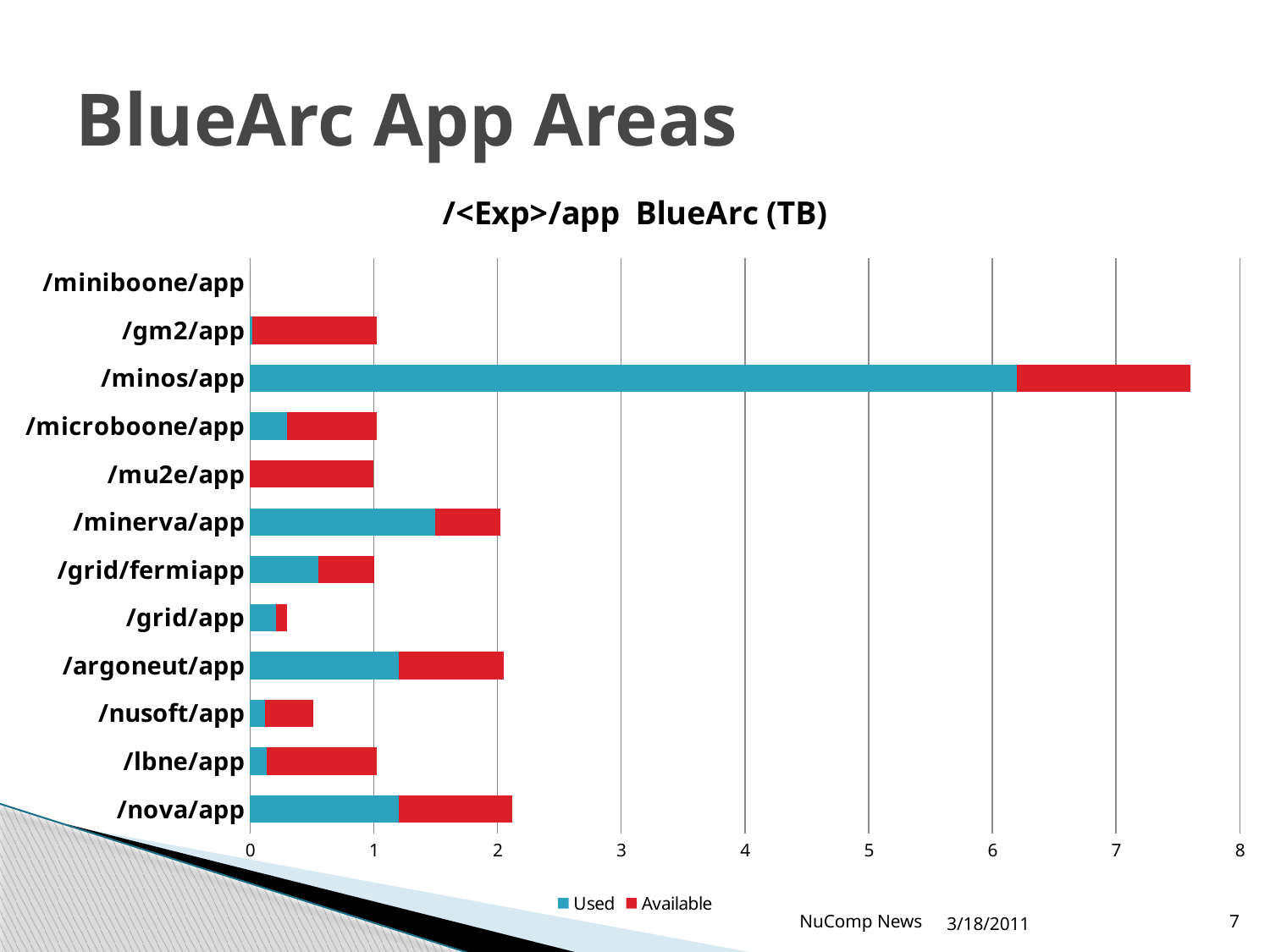
Which has the larger Used value, /minerva/app or /argoneut/app? /minerva/app Which colour represents the Available series in the chart? red How many app areas (categories) are listed on the vertical axis of the chart? 12 Is the total bar for /grid/app greater or less than 1? less Is the Used value for /minos/app greater or less than 5? greater Which has the larger total bar, /grid/app or /nusoft/app? /nusoft/app Which app area shows no bar at all in the chart? /miniboone/app How many series does the chart legend list? 2 Which app area has the longest total bar in the chart? /minos/app What is the title of the chart? /<Exp>/app BlueArc (TB) Is the total bar for /minos/app greater or less than 7? greater What kind of chart is shown on the slide? stacked bar chart